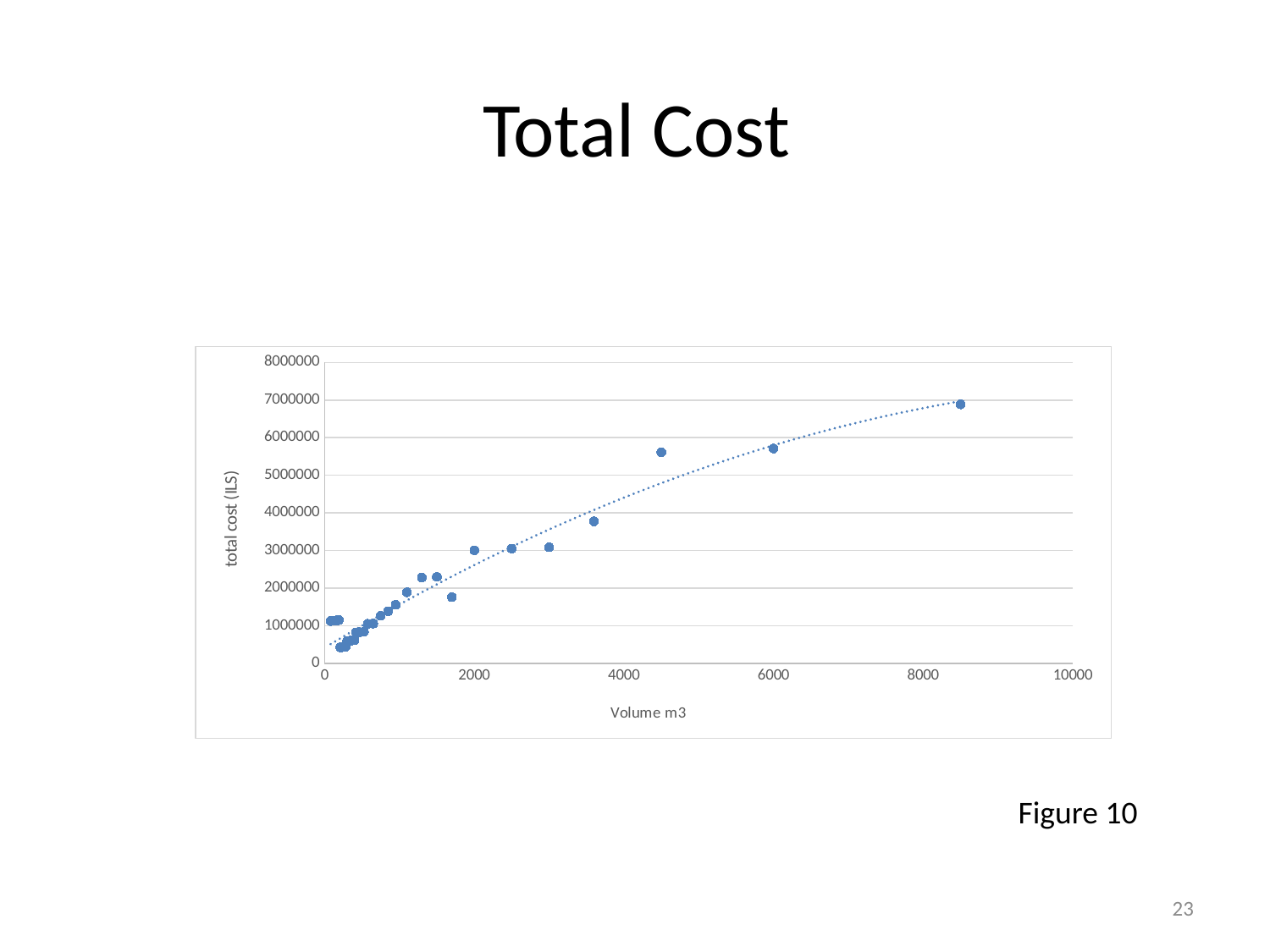
Which point has the highest total cost: the one at about 6000 m3 or the one at about 8500 m3? the one at about 8500 m3 Do the plotted total cost values rise or fall as volume increases along the x axis? rise Is the total cost for the rightmost point (near 8500 m3) greater or less than 6000000? greater What is the label of the vertical axis of the chart? total cost (ILS) What is the title of the chart on the slide? Total Cost Is the total cost for the point at about 1700 m3 greater or less than 2000000? less Is the total cost for the point at about 3000 m3 greater or less than 2000000? greater What kind of chart is shown on the slide? scatter chart What is the highest value shown on the x axis of the chart? 10000